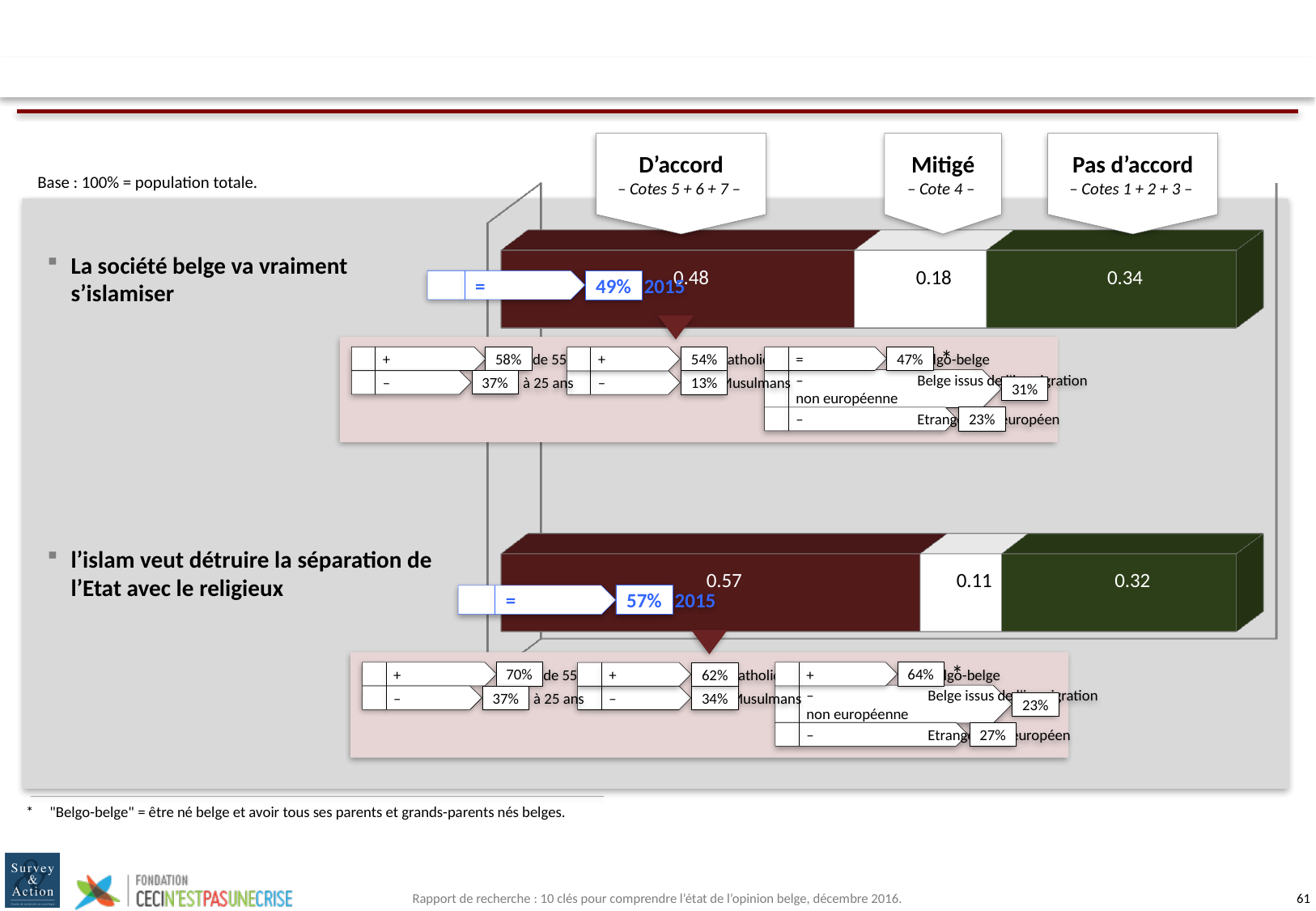
For the statement "l'islam veut détruire la séparation de l'Etat avec le religieux", what is the value of the "Mitigé" segment? 0.11 For the statement "La société belge va vraiment s'islamiser", what is the value of the "Mitigé" segment? 0.18 For the statement "l'islam veut détruire la séparation de l'Etat avec le religieux", what is the value of the "Pas d'accord" segment? 0.32 In the bar for "La société belge va vraiment s'islamiser", which segment is the largest? D'accord How many response segments does each bar contain? 3 For the statement "La société belge va vraiment s'islamiser", what is the value of the "Pas d'accord" segment? 0.34 What is the difference between the "D'accord" values of the two statements? 0.09 What kind of chart is used to show the responses to the two statements? Stacked bar chart In the bar for "l'islam veut détruire la séparation de l'Etat avec le religieux", which segment is the smallest? Mitigé Which statement has the larger "Pas d'accord" value? La société belge va vraiment s'islamiser For the statement "l'islam veut détruire la séparation de l'Etat avec le religieux", what is the value of the "D'accord" segment? 0.57 For the statement "La société belge va vraiment s'islamiser", what is the value of the "D'accord" segment? 0.48